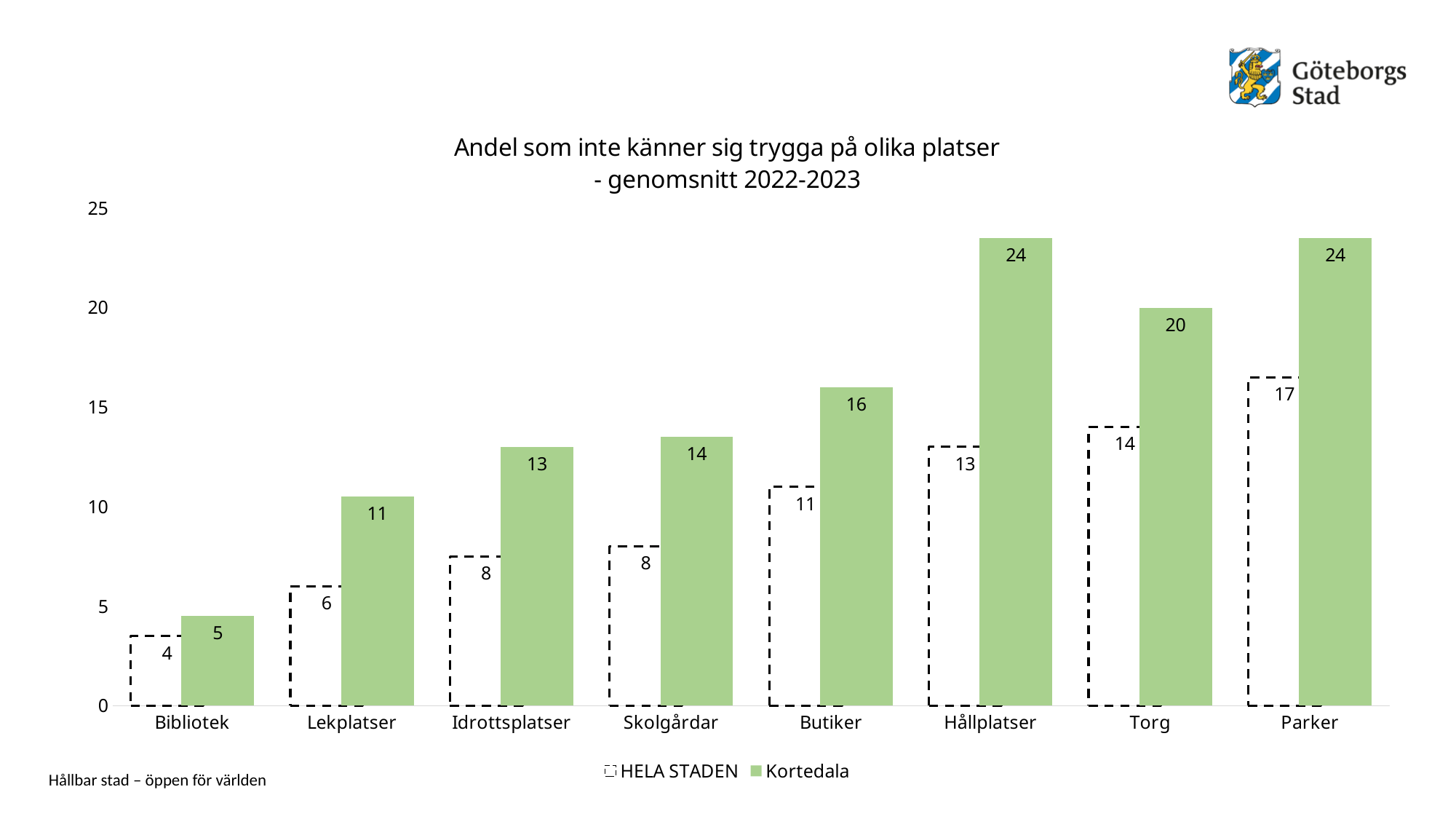
What kind of chart is shown on the slide? Bar chart Which is larger at Lekplatser: HELA STADEN or Kortedala? Kortedala Which series is drawn with a dashed outline in the legend? HELA STADEN Which category has the highest value for HELA STADEN? Parker How many categories are shown on the x axis? 8 Which category has the lowest value for Kortedala? Bibliotek Do the Kortedala values generally rise or fall from Bibliotek to Parker? Rise What is the value for Kortedala at Torg? 20 How many series does the legend list? 2 What is the difference between Kortedala and HELA STADEN at Hållplatser? 11 What is the value for HELA STADEN at Skolgårdar? 8 What is the value for Kortedala at Butiker? 16